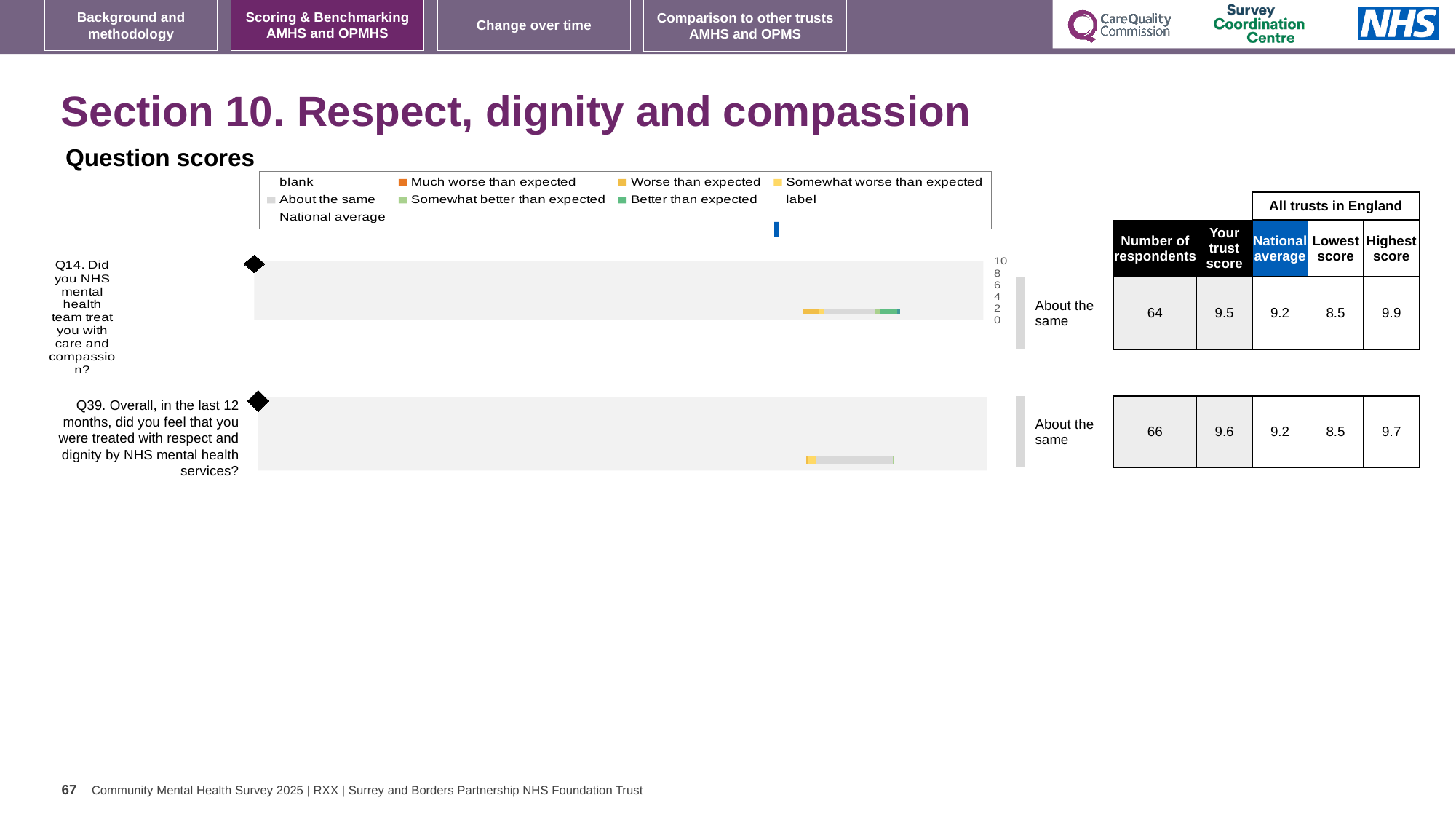
What kind of chart is used to show the question scores on this slide? bar chart Which question has the higher highest score across all trusts in England? Q14 What benchmark category is shown for Q39? About the same What is the difference between the trust score and the national average for Q14? 0.3 How many respondents answered Q14? 64 How many questions are plotted in the question scores chart? 2 What is the lowest score among all trusts in England for Q14? 8.5 What is the trust score for Q14 (care and compassion)? 9.5 What is the national average score for Q14? 9.2 What is the highest score among all trusts in England for Q39? 9.7 What is the trust score for Q39 (respect and dignity)? 9.6 Which question has the higher trust score, Q14 or Q39? Q39